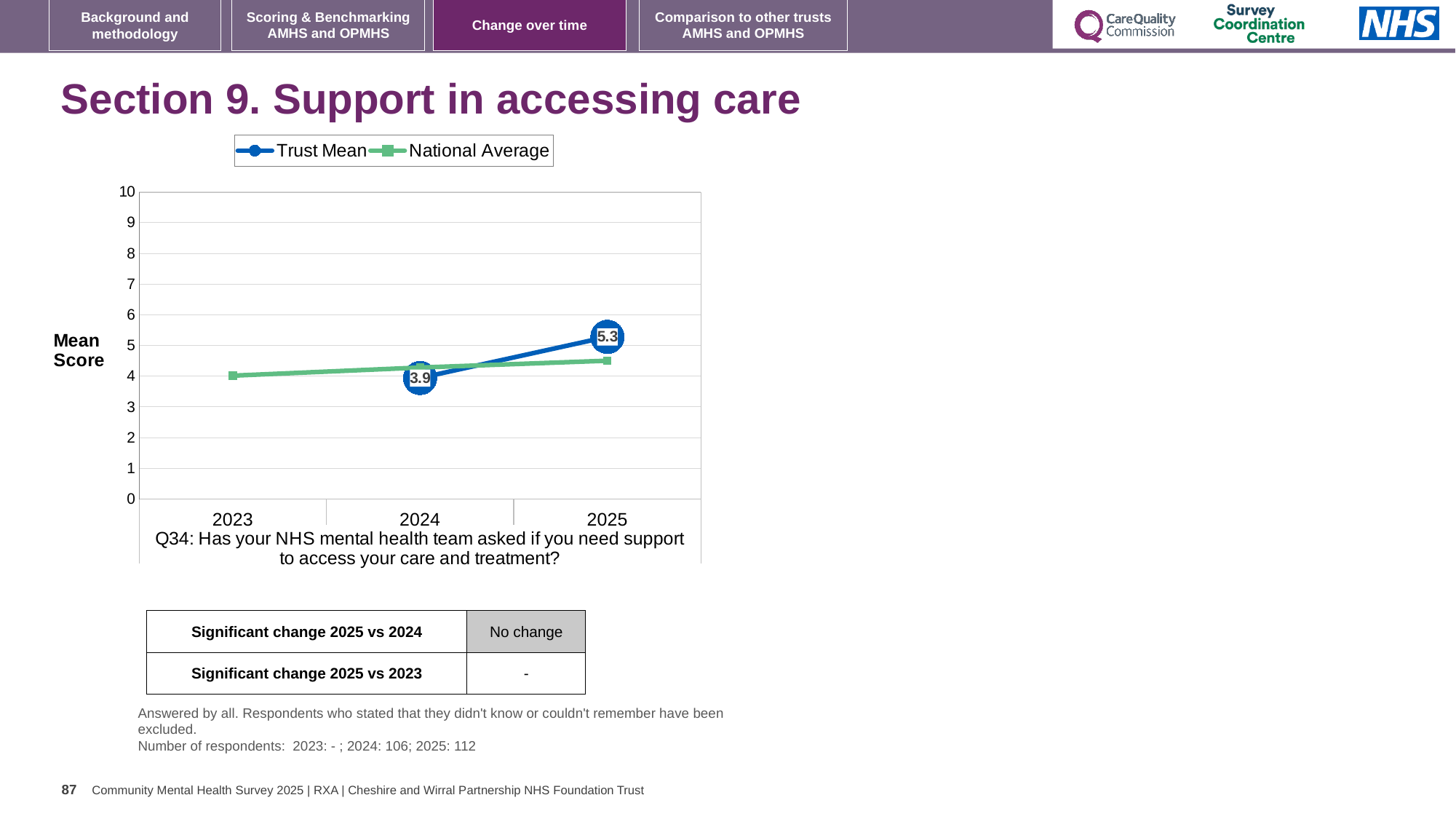
What is the Trust Mean value for 2025? 5.3 In 2024, which is higher: the Trust Mean or the National Average? National Average How many years are shown on the x axis of the chart? 3 What kind of chart is shown on the slide? Line chart How many series does the chart legend list? 2 By how much did the Trust Mean change from 2024 to 2025? 1.4 What is the label on the y axis of the chart? Mean Score Does the Trust Mean rise or fall from 2024 to 2025? Rise In 2025, which is higher: the Trust Mean or the National Average? Trust Mean What is the Trust Mean value for 2024? 3.9 Is the National Average value for 2025 greater or less than 3? greater Is the National Average value for 2023 greater or less than 5? less